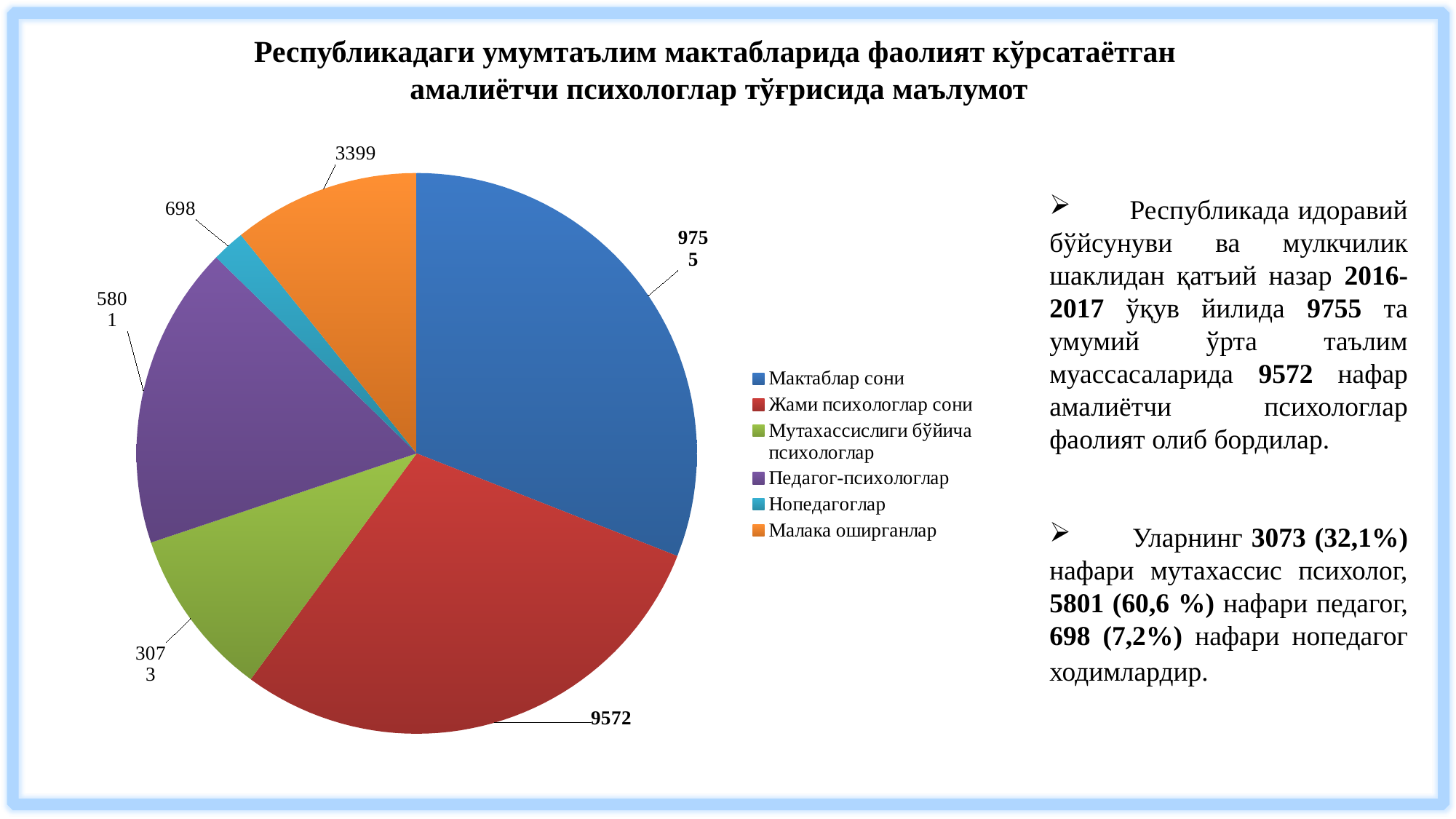
What type of chart is shown on the slide? Pie chart What value is shown for Нопедагоглар? 698 Which category has the largest slice of the pie? Мактаблар сони What is the difference between the values for Мактаблар сони and Жами психологлар сони? 183 What value is shown for Мактаблар сони? 9755 What value is shown for Малака оширганлар? 3399 Which is larger, the value for Малака оширганлар or the value for Мутахассислиги бўйича психологлар? Малака оширганлар Which category has the smallest slice of the pie? Нопедагоглар What value is shown for Жами психологлар сони? 9572 How many slices does the pie chart have? 6 What is the difference between the values for Педагог-психологлар and Мутахассислиги бўйича психологлар? 2728 What value is shown for Педагог-психологлар? 5801